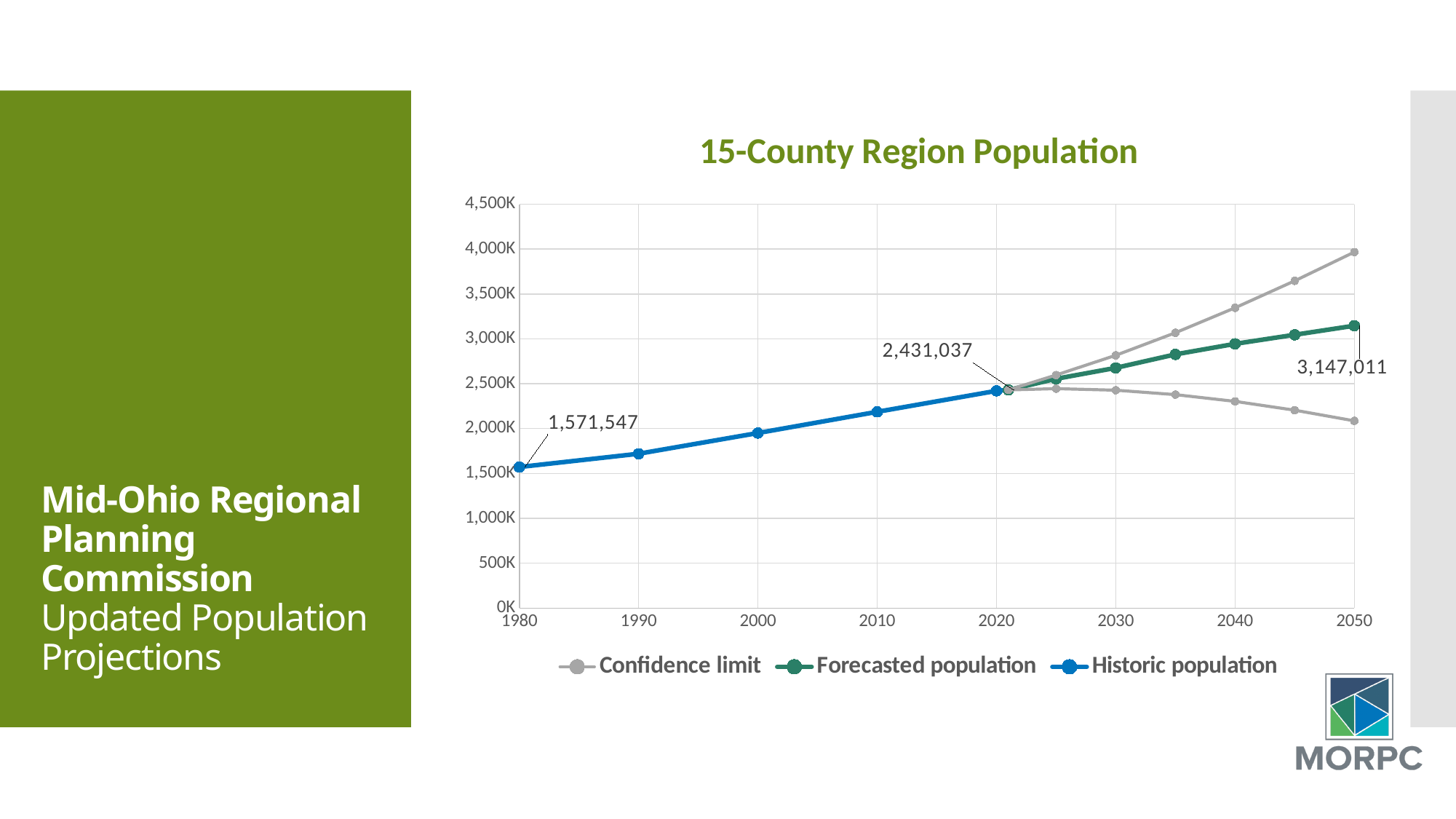
Is the upper confidence limit value at 2050 greater or less than 3,500K? greater Does the historic population rise or fall from 1980 to 2020? Rise How many series does the legend list? 3 Which is larger: the forecasted population in 2050 or the population in 2020? Forecasted population in 2050 What is the title of the chart? 15-County Region Population What is the difference between the forecasted population in 2050 and the population in 2020? 715,974 What is the forecasted population labelled for 2050? 3,147,011 What kind of chart is shown on the slide? Line chart What population value is labelled at 2020? 2,431,037 What is the historic population value labelled for 1980? 1,571,547 By how much did the population grow between 1980 and 2020, according to the labelled values? 859,490 Is the lower confidence limit value at 2050 greater or less than 2,500K? less